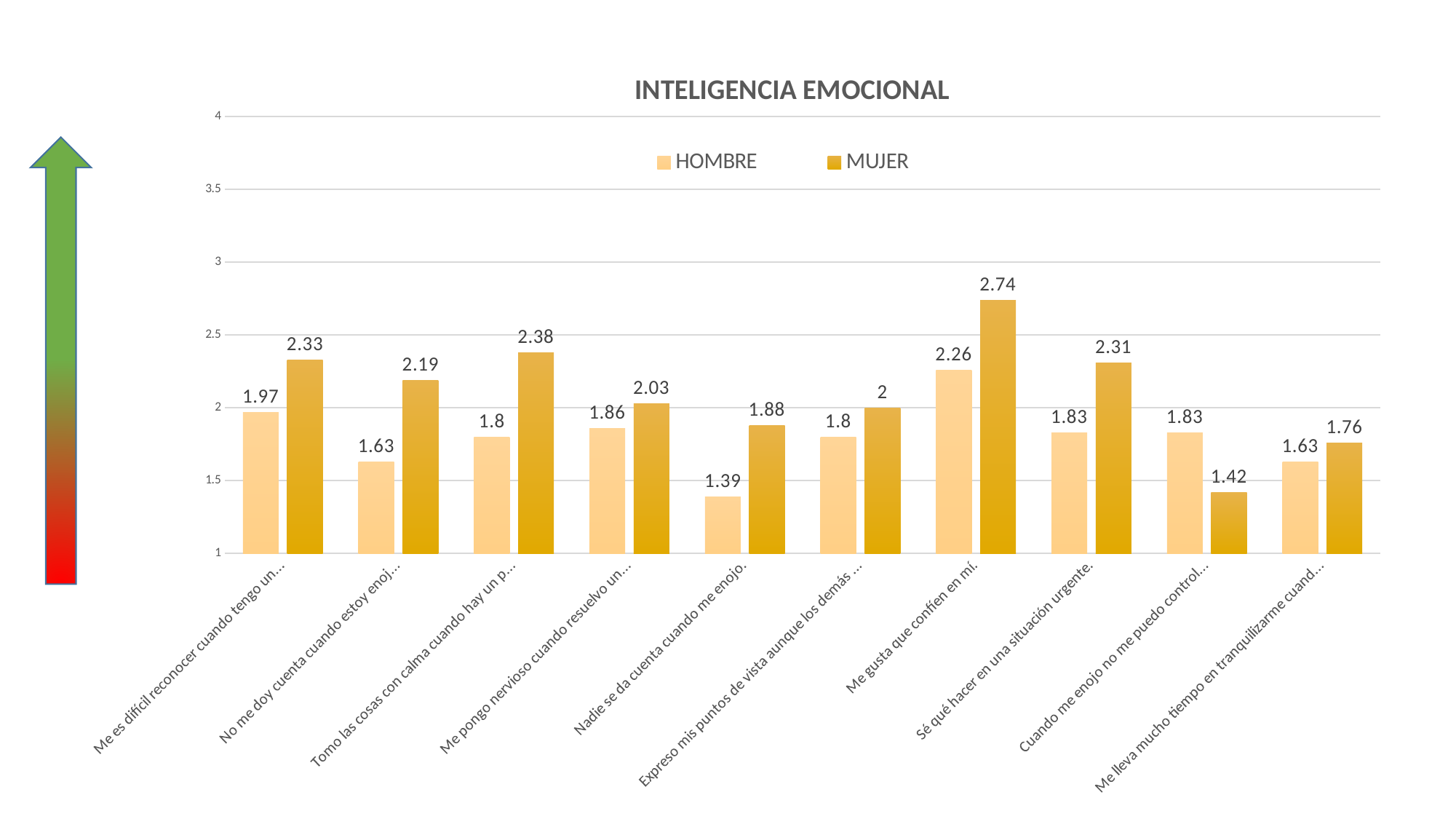
What is the MUJER value for "Sé qué hacer en una situación urgente."? 2.31 How many categories are shown on the x axis? 10 Is the HOMBRE value for "Nadie se da cuenta cuando me enojo." greater or less than 1.5? less What is the HOMBRE value for "Me gusta que confíen en mí."? 2.26 What kind of chart is shown? bar chart Which category has the lowest HOMBRE value? Nadie se da cuenta cuando me enojo. How many series does the legend list? 2 What is the MUJER value for "Nadie se da cuenta cuando me enojo."? 1.88 What is the difference between the MUJER and HOMBRE values for "Me gusta que confíen en mí."? 0.48 Which category has the highest MUJER value? Me gusta que confíen en mí. What is the title of the chart? INTELIGENCIA EMOCIONAL For "Sé qué hacer en una situación urgente.", which series has the larger value, HOMBRE or MUJER? MUJER